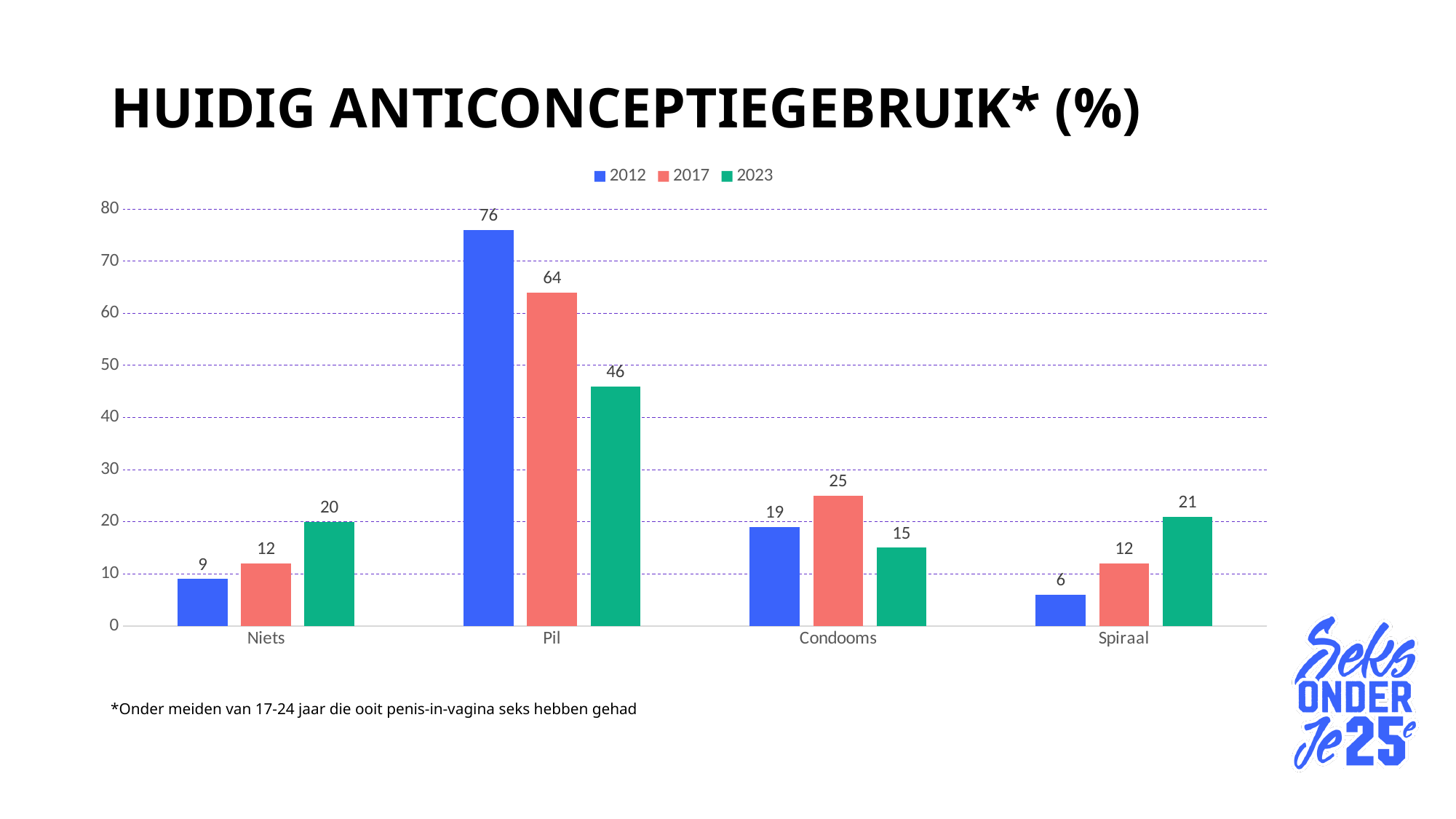
What is the value for Spiraal in 2023? 21 What is the value for Condooms in 2017? 25 What is the difference between the 2012 and 2023 values for Pil? 30 What kind of chart is shown on the slide? Bar chart How many categories are shown on the x axis? 4 How many series does the legend list? 3 Which category has the lowest value in 2012? Spiraal What is the value for Pil in 2012? 76 Which category has the highest value in 2023? Pil Does the value for Pil rise or fall from 2012 to 2023? Fall What is the title of the chart? HUIDIG ANTICONCEPTIEGEBRUIK* (%) Which is larger: the 2023 value for Niets or the 2023 value for Condooms? Niets